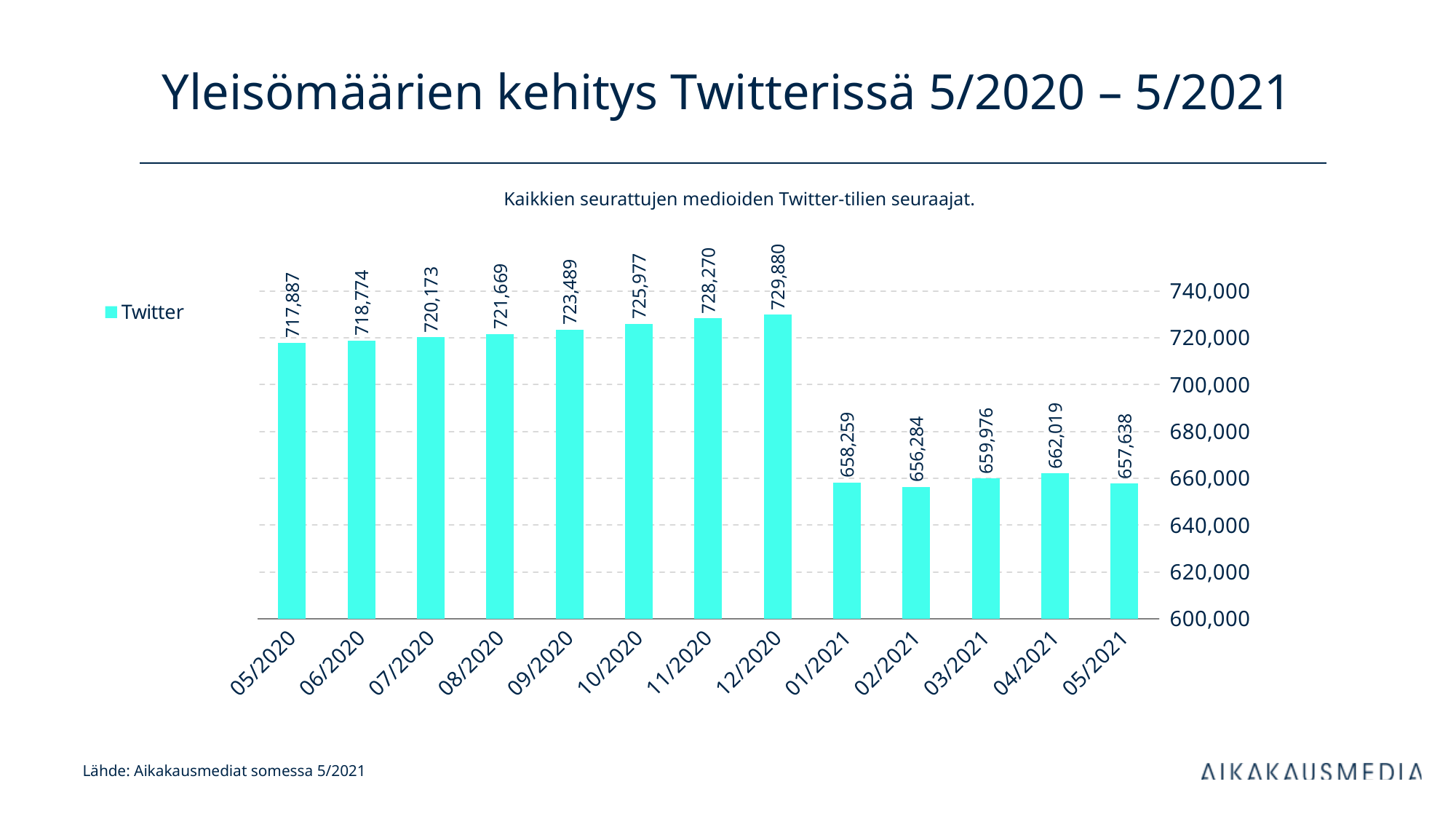
Which month has the highest value? 12/2020 What is the difference between the values for 12/2020 and 01/2021? 71,621 How many months are shown on the x axis? 13 What kind of chart is this? bar chart Is the value for 11/2020 greater or less than 720,000? greater Do the values rise or fall from 05/2020 to 12/2020? rise Which month has the lowest value? 02/2021 What is the value for 12/2020? 729,880 What is the value for 04/2021? 662,019 Which is larger, the value for 03/2021 or the value for 05/2021? 03/2021 What is the value for 05/2020? 717,887 What is the value for 02/2021? 656,284